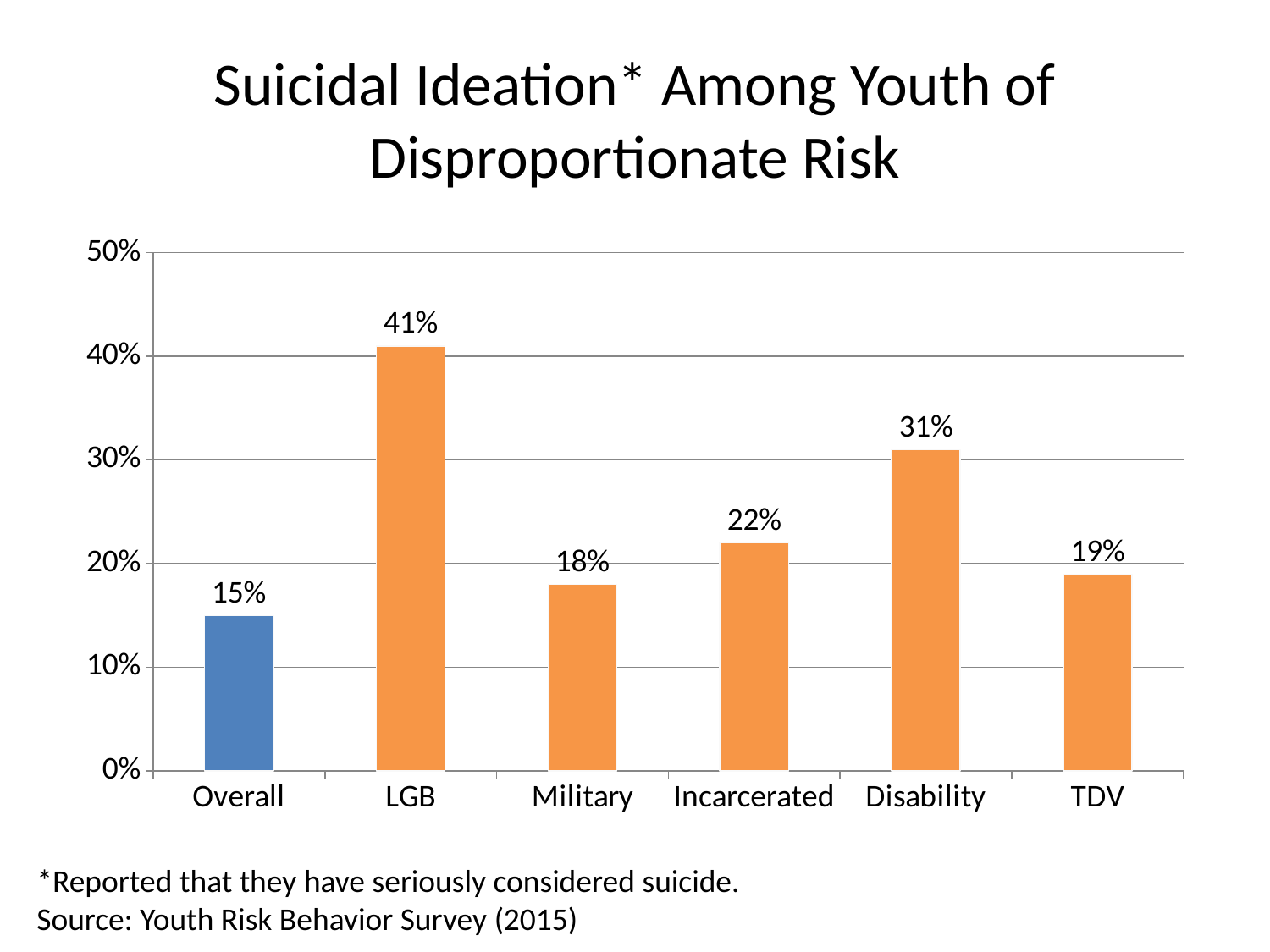
What kind of chart is shown on the slide? Bar chart What is the difference between the values for Disability and Incarcerated? 9% What is the value for Disability? 31% Which category has the lowest value? Overall What is the value for TDV? 19% What is the value for Overall? 15% Which category has the highest value? LGB Is the value for Disability greater or less than 30%? greater What is the value for LGB? 41% Which is larger, the value for Military or the value for Incarcerated? Incarcerated How many categories are shown on the x axis? 6 What is the difference between the values for LGB and Overall? 26%